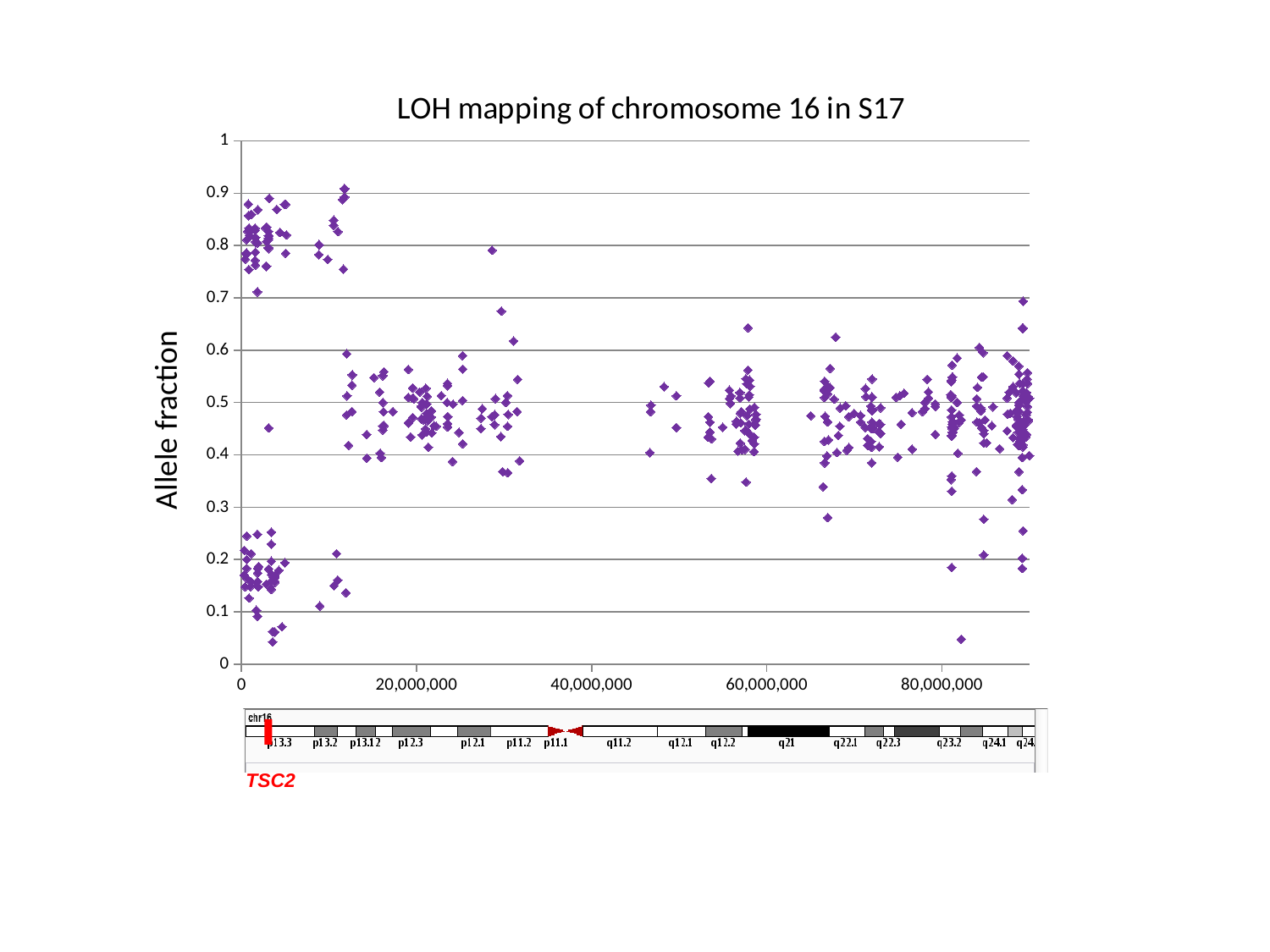
Are any points plotted between 35,000,000 and 45,000,000 on the horizontal axis of the chart? No Are any points in the chart plotted below an allele fraction of 0.1? Yes What is the highest value shown on the vertical axis of the chart? 1 What is the title of the chart? LOH mapping of chromosome 16 in S17 What is the label on the vertical axis of the chart? Allele fraction What kind of chart is shown on the slide? Scatter plot